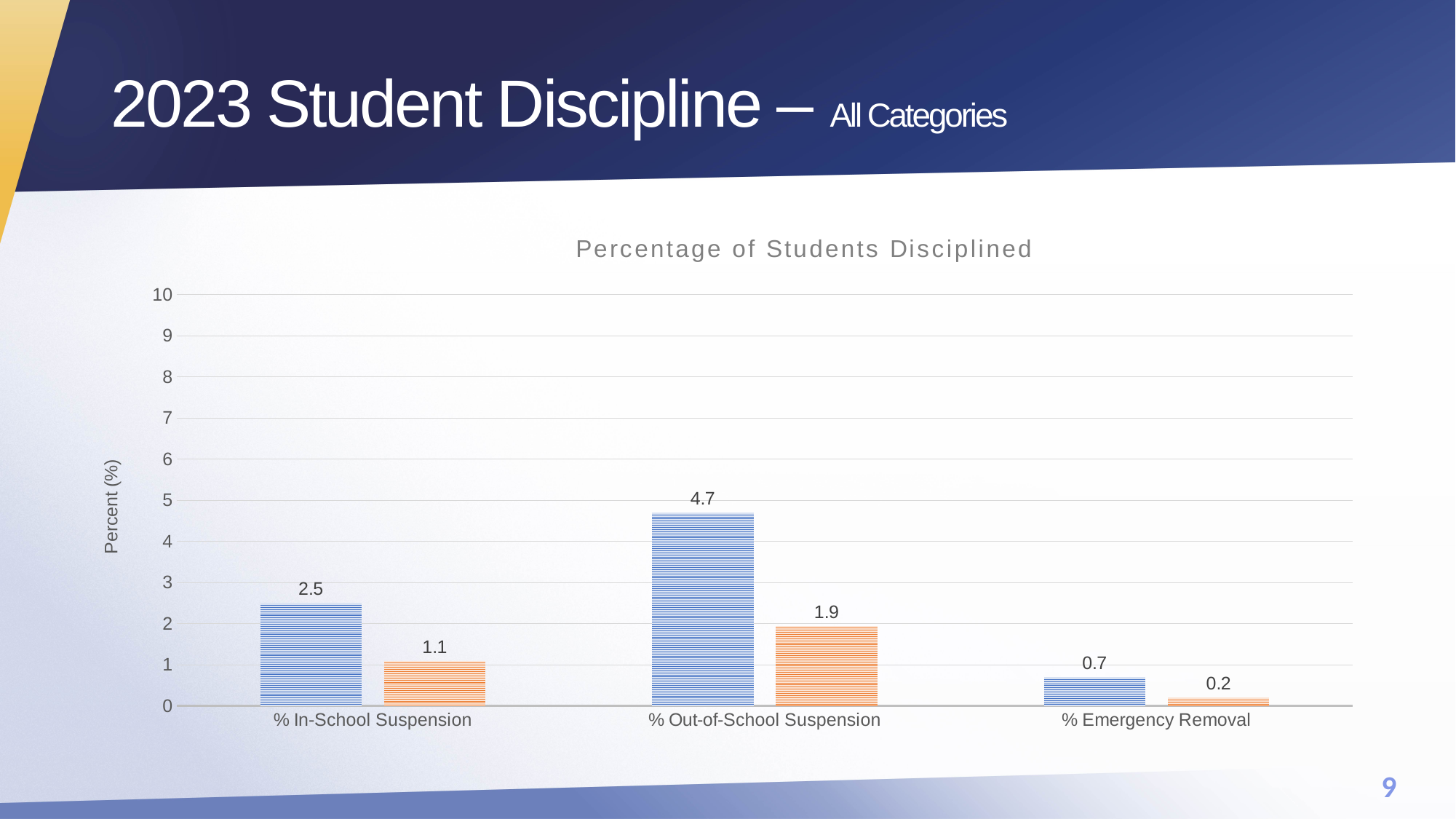
What is the title of the chart? Percentage of Students Disciplined How many categories are shown on the x axis? 3 What is the value of the orange bar for % Out-of-School Suspension? 1.9 Which category has the lowest orange bar? % Emergency Removal What kind of chart is shown on the slide? Bar chart What is the value of the blue bar for % In-School Suspension? 2.5 Which category has the highest blue bar? % Out-of-School Suspension What is the value of the orange bar for % Emergency Removal? 0.2 What is the value of the blue bar for % Emergency Removal? 0.7 What is the difference between the blue bars for % In-School Suspension and % Emergency Removal? 1.8 What is the difference between the blue and orange bars for % Out-of-School Suspension? 2.8 Which is larger: the orange bar for % In-School Suspension or the orange bar for % Out-of-School Suspension? % Out-of-School Suspension